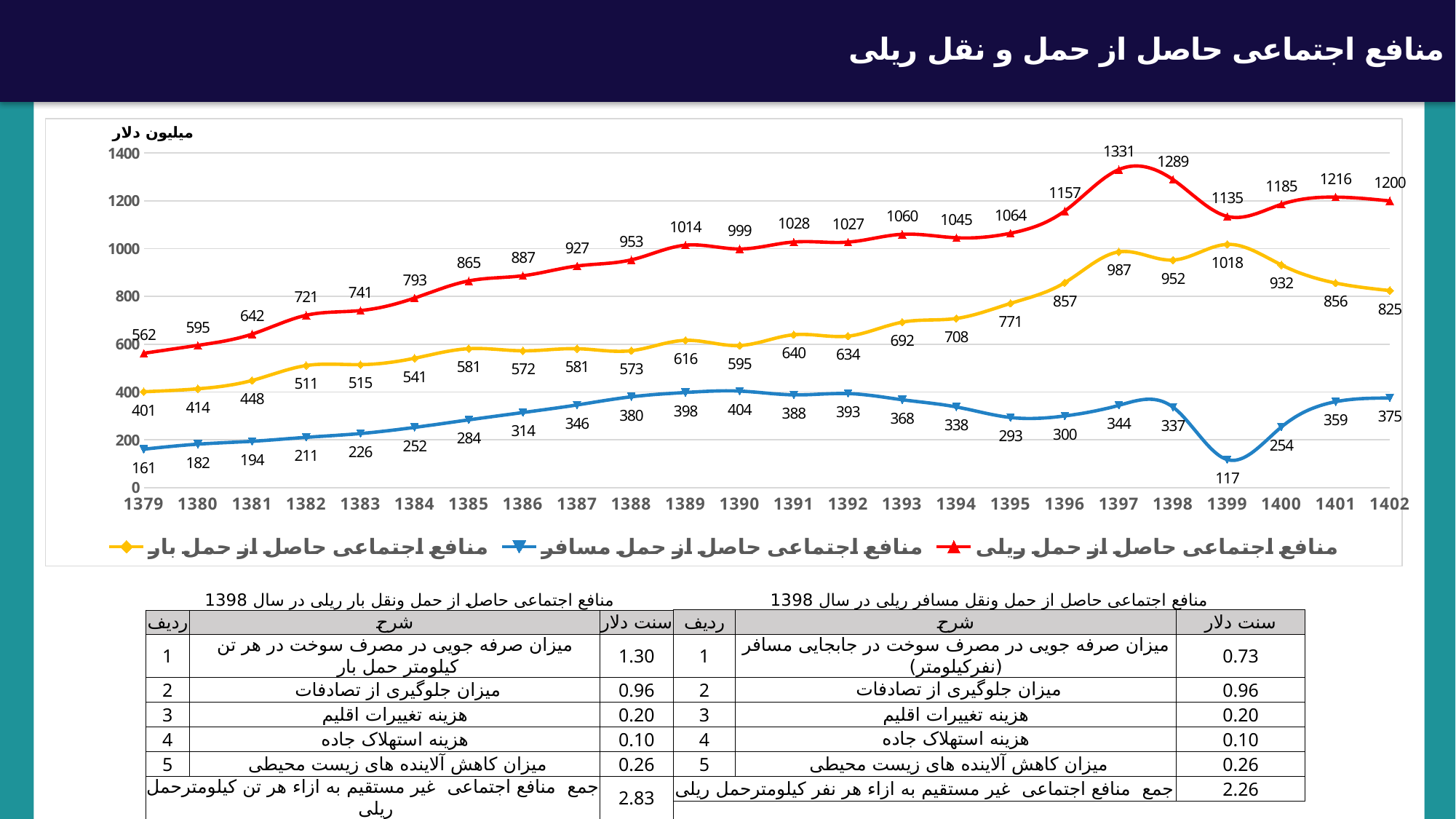
In which year does the yellow series (منافع اجتماعی حاصل از حمل بار) reach its highest value? 1399 In which year does the blue series (منافع اجتماعی حاصل از حمل مسافر) reach its lowest value? 1399 How many series does the chart's legend list? 3 In which year does the red series (منافع اجتماعی حاصل از حمل ریلی) reach its highest value? 1397 Is the value of the blue series (منافع اجتماعی حاصل از حمل مسافر) in 1399 greater or less than 200? less What is the difference between the red series and the yellow series in 1402? 375 For the yellow series (منافع اجتماعی حاصل از حمل بار), which year has the larger value, 1397 or 1399? 1399 What is the value of the red series (منافع اجتماعی حاصل از حمل ریلی) in 1397? 1331 What kind of chart is shown on the slide? line chart What is the value of the yellow series (منافع اجتماعی حاصل از حمل بار) in 1402? 825 How many years are shown on the x axis of the chart? 24 What is the value of the blue series (منافع اجتماعی حاصل از حمل مسافر) in 1399? 117